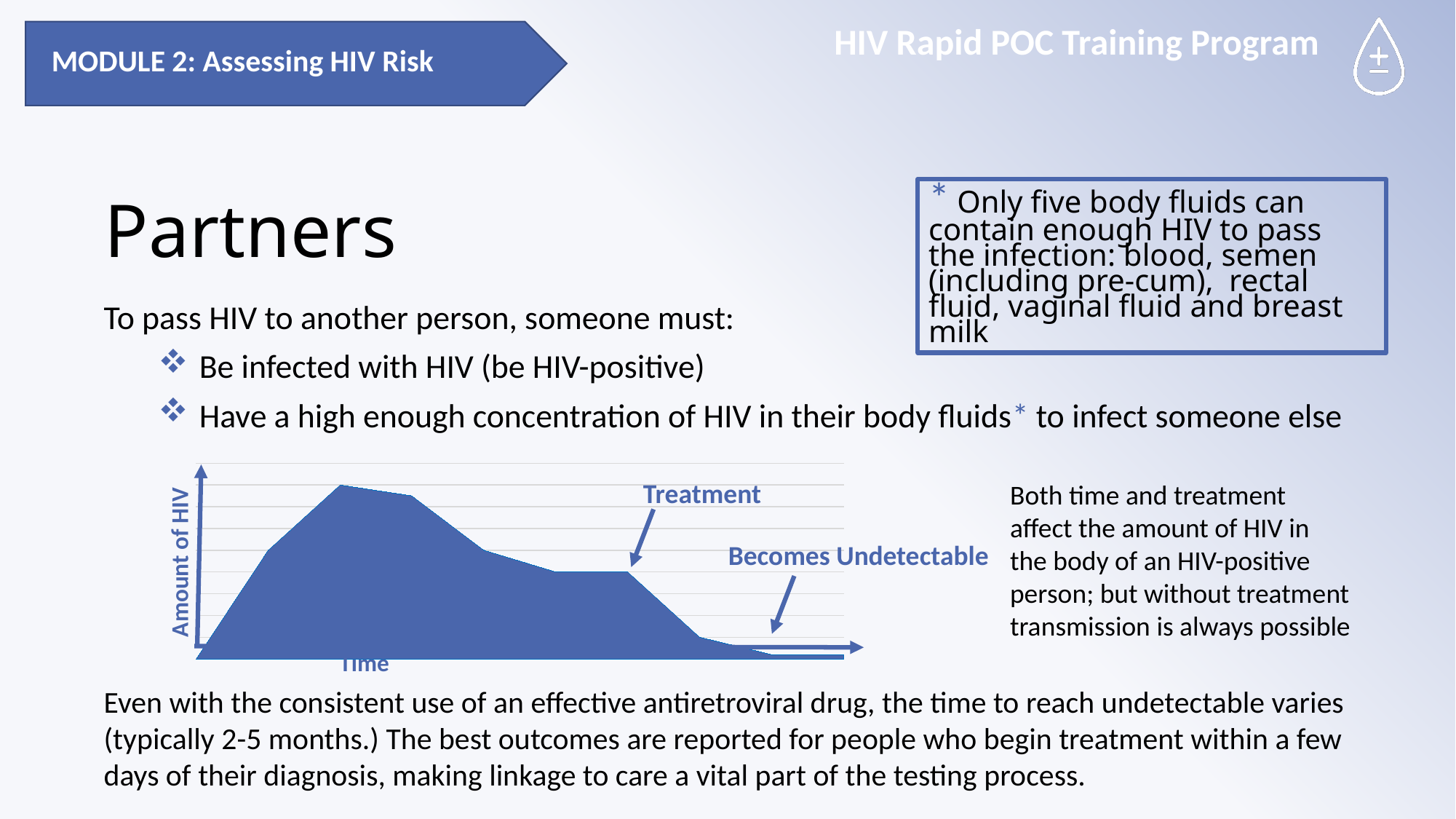
What kind of chart is shown on the slide? Area chart After the point labelled "Treatment", does the amount of HIV rise or fall over time? Fall Toward the right end of the chart, after the point labelled "Becomes Undetectable", is the amount of HIV at its highest or lowest level? Lowest What is the label on the vertical axis of the chart? Amount of HIV At the start of the chart, does the amount of HIV rise or fall over time? Rise What is the label on the horizontal axis of the chart? Time